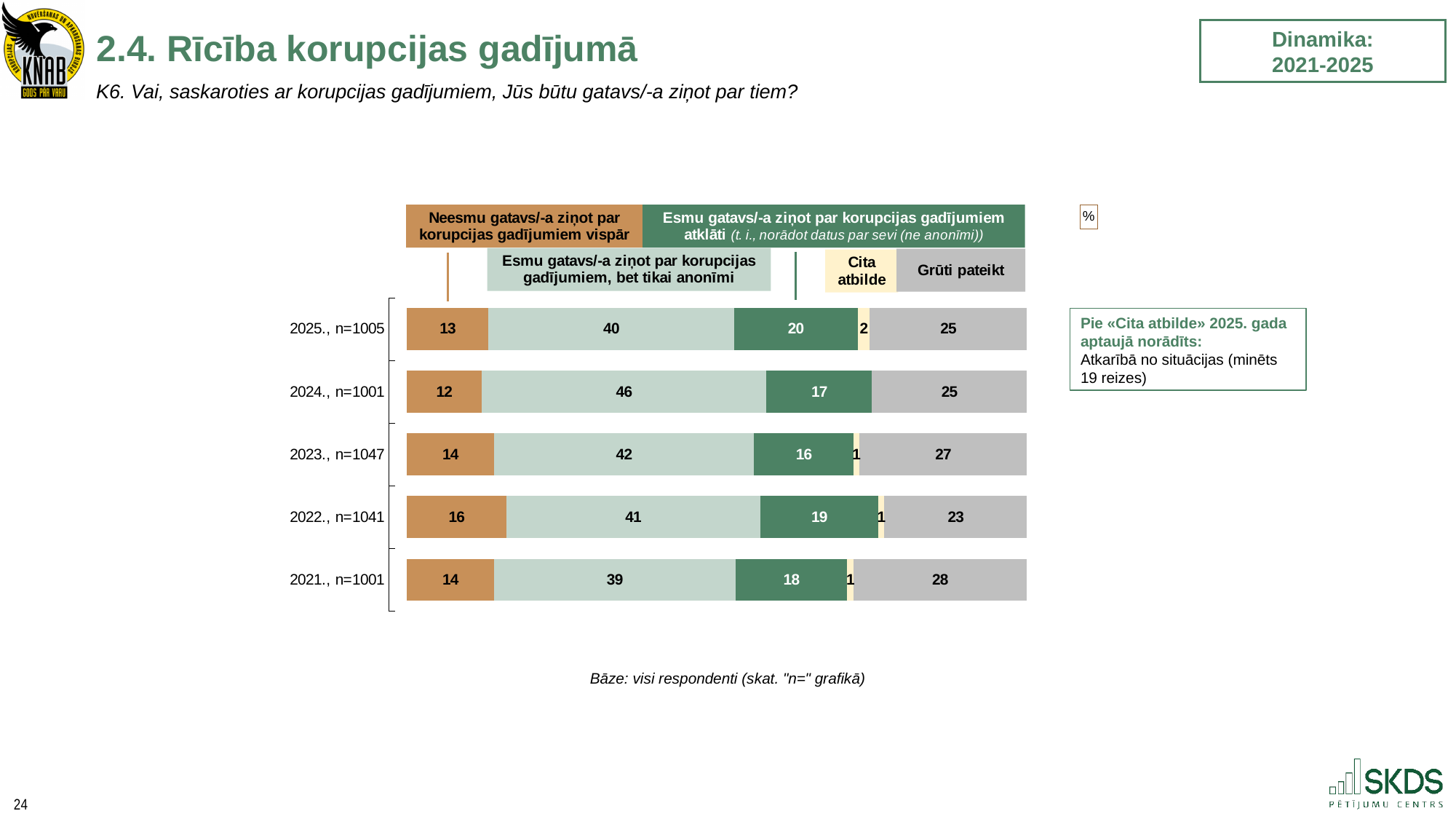
What is the sample size (n) shown for 2023? 1047 What is the value for "Esmu gatavs/-a ziņot par korupcijas gadījumiem, bet tikai anonīmi" in 2024? 46 How many years (bars) are shown in the chart? 5 What is the value for "Esmu gatavs/-a ziņot par korupcijas gadījumiem atklāti" in 2025? 20 What kind of chart is shown on the slide? Stacked bar chart How many series does the legend list? 5 In which year is the value for "Esmu gatavs/-a ziņot par korupcijas gadījumiem atklāti" the lowest? 2023 Which is larger: the "bet tikai anonīmi" value in 2023 or in 2025? 2023 What is the value for "Grūti pateikt" in 2021? 28 What is the total of the stacked bar for 2025? 100 In which year is the value for "Neesmu gatavs/-a ziņot par korupcijas gadījumiem vispār" the highest? 2022 What is the difference between the "Grūti pateikt" values for 2021 and 2022? 5